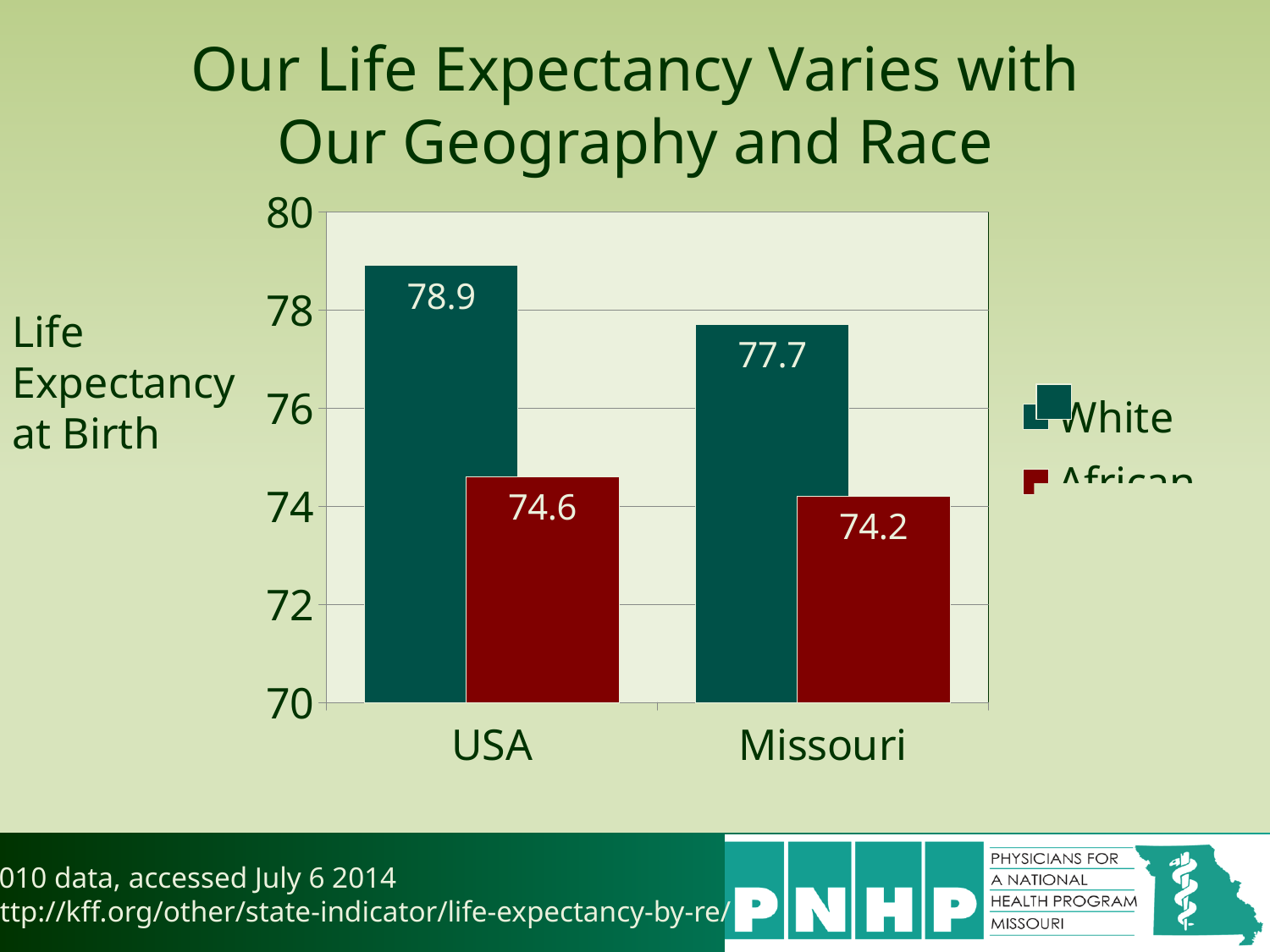
Which bar has the lowest value on the chart? the dark red bar for Missouri What is the life expectancy at birth for White in the USA? 78.9 What value does the dark red bar show for the USA? 74.6 Is the White value for Missouri greater or less than 76? greater What is the life expectancy at birth for White in Missouri? 77.7 What type of chart is shown on the slide? bar chart Which bar has the highest value on the chart? White, USA What value does the dark red bar show for Missouri? 74.2 What is the difference between the White bar and the dark red bar for the USA? 4.3 What is the difference between the White values for the USA and Missouri? 1.2 How many series does the legend list? 2 How many categories are shown on the x axis? 2